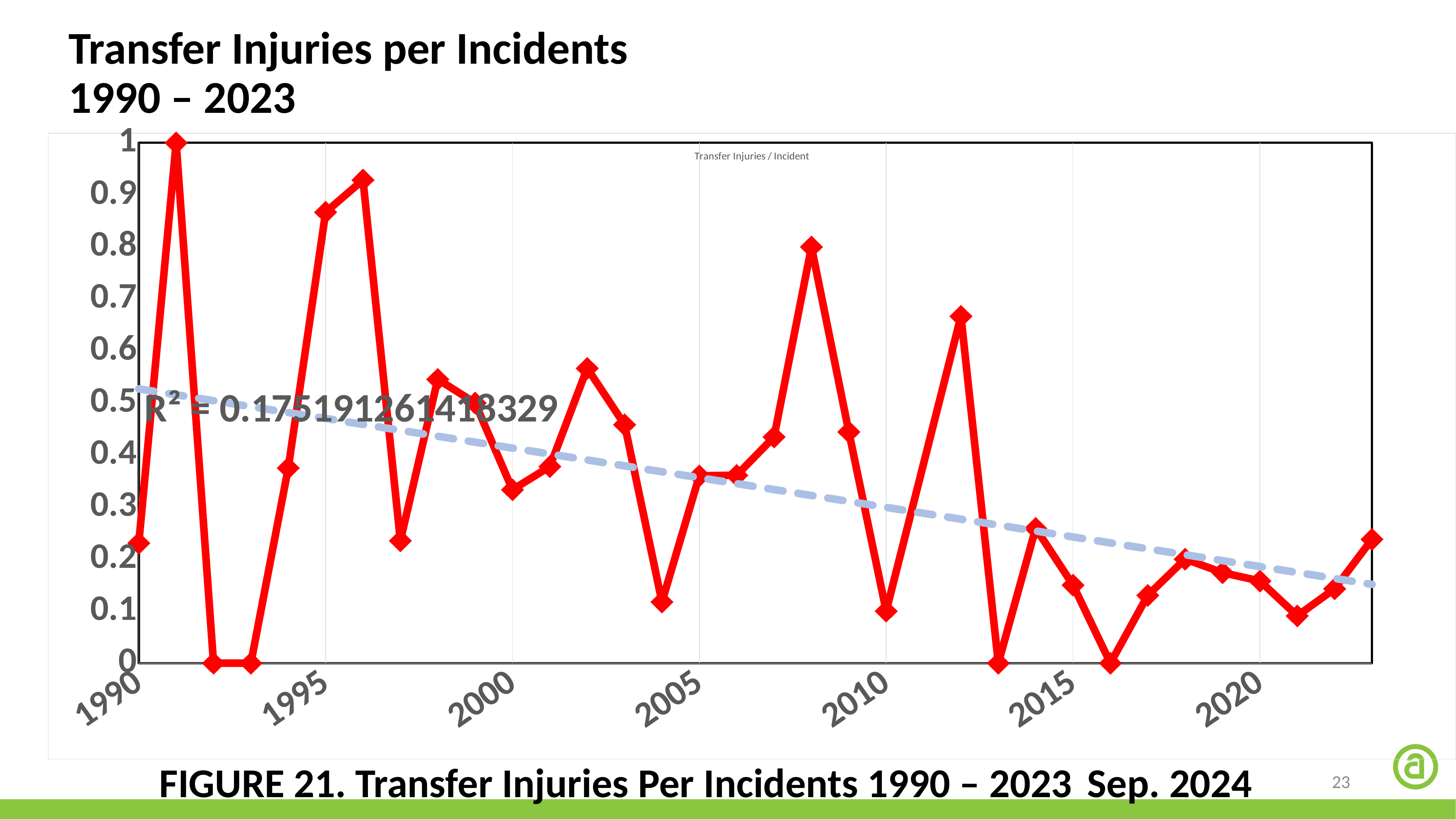
Is the value for 1995 greater or less than 0.8? greater Which has the larger value, 2005 or 2010? 2005 Is the value for 2010 greater or less than 0.2? less Which has the larger value, 1995 or 2000? 1995 How many year labels are shown on the x axis? 7 What is the title of the chart on the slide? Transfer Injuries per Incidents 1990 – 2023 What is the lowest value reached by the red line on the chart? 0 Is the value for 1990 greater or less than 0.3? less Does the dashed trend line rise or fall from 1990 to 2023? fall What is the highest value reached by the red line on the chart? 1 What R² value is printed on the chart? R² = 0.175191261418329 What kind of chart is shown on the slide? line chart